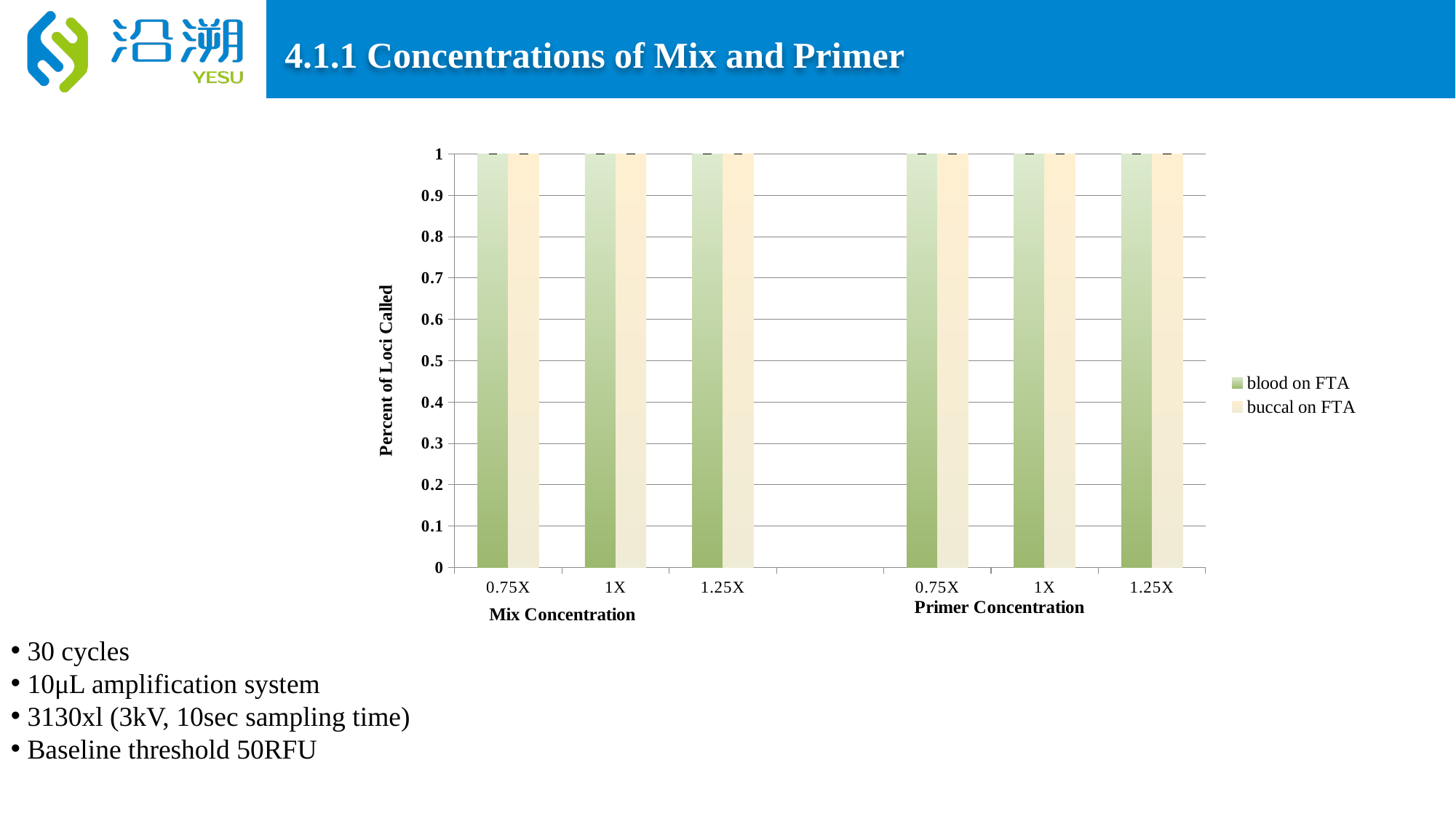
What is the value for buccal on FTA at 1.25X Primer Concentration? 1 What is the label of the vertical axis? Percent of Loci Called What kind of chart is shown on the slide? bar chart Is the value for buccal on FTA at 0.75X Mix Concentration greater or less than 0.5? greater How many concentration categories are shown on the x axis in total? 6 What is the value for blood on FTA at 0.75X Primer Concentration? 1 What is the difference between the blood on FTA and buccal on FTA values at 1X Primer Concentration? 0 How many categories are shown under Mix Concentration? 3 What are the two series named in the legend? blood on FTA and buccal on FTA How many series does the legend list? 2 Do the blood on FTA values rise, fall, or stay the same across the Mix Concentration categories? stay the same What is the value for blood on FTA at 1X Mix Concentration? 1